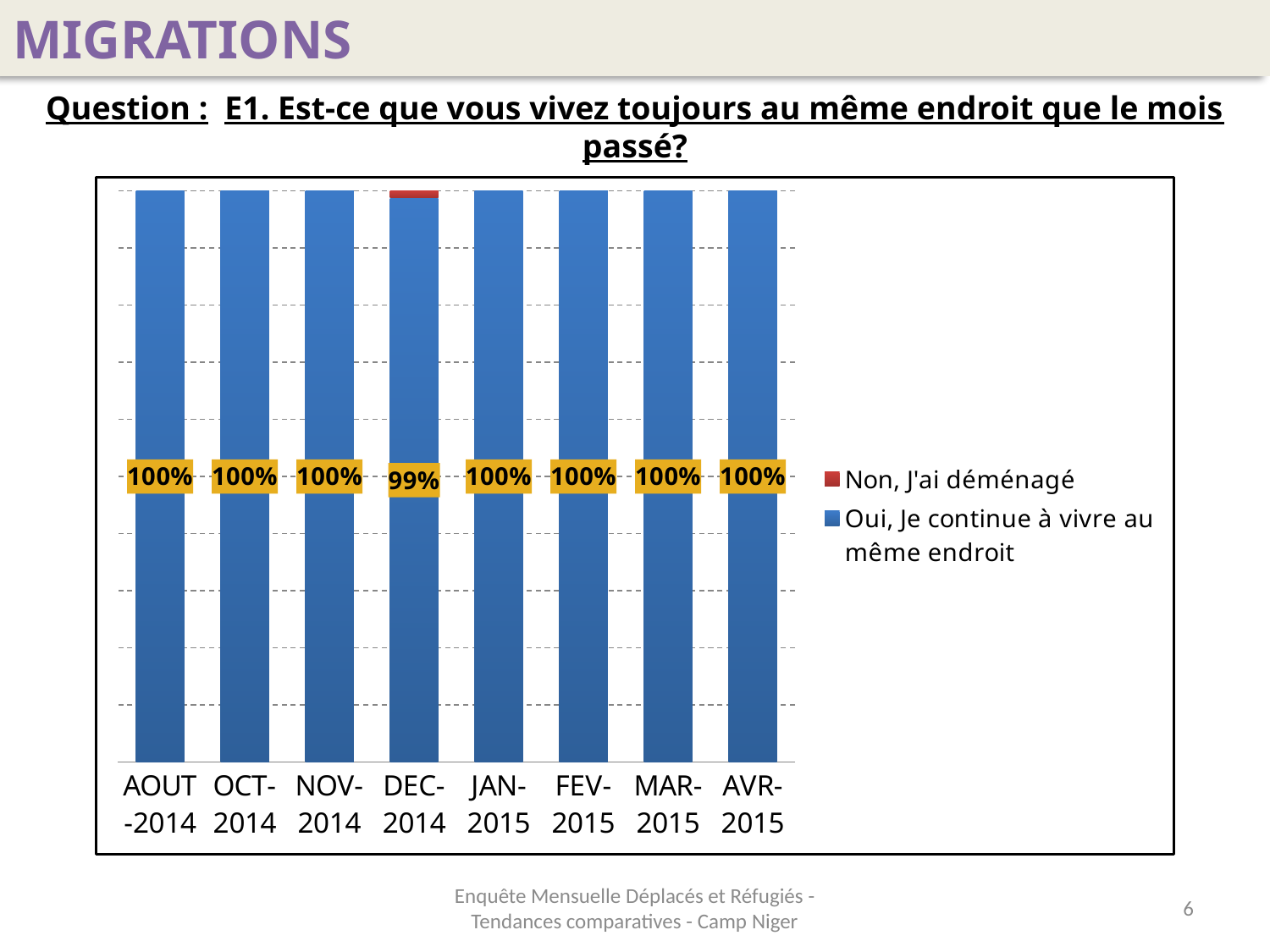
How many months are shown on the x axis? 8 What is the difference between the "Oui" values for AOUT-2014 and DEC-2014? 1% What is the value of "Oui, Je continue à vivre au même endroit" for JAN-2015? 100% What is the value of "Oui, Je continue à vivre au même endroit" for AVR-2015? 100% Which month is the only one showing a visible segment for "Non, J'ai déménagé"? DEC-2014 What colour represents the series "Non, J'ai déménagé" in the legend? Red What is the value of "Oui, Je continue à vivre au même endroit" for DEC-2014? 99% How many series does the legend list? 2 Which is larger, the "Oui" value for NOV-2014 or for DEC-2014? NOV-2014 What kind of chart is shown on the slide? Stacked bar chart Which month has the lowest value for "Oui, Je continue à vivre au même endroit"? DEC-2014 What is the value of "Oui, Je continue à vivre au même endroit" for AOUT-2014? 100%